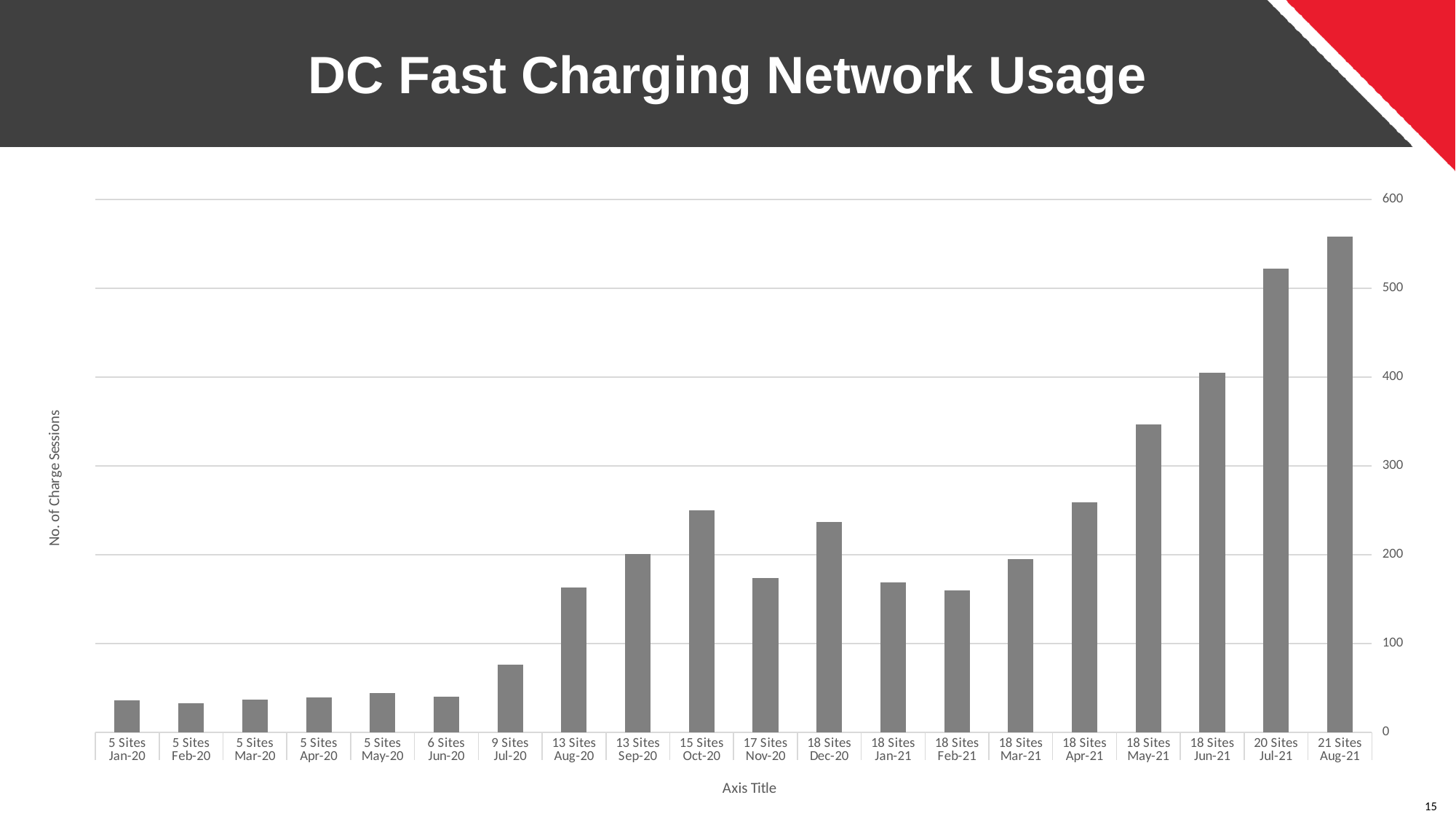
Overall, do the number of charge sessions rise or fall from Jan-20 to Aug-21? rise How many months (bars) are plotted on the chart? 20 Which has more charge sessions, Dec-20 or Jan-21? Dec-20 Is the value for Feb-21 greater or less than 200? less What is the title of the vertical axis? No. of Charge Sessions Is the value for May-21 greater or less than 300? greater Which has more charge sessions, Oct-20 or Nov-20? Oct-20 Which month has the highest number of charge sessions? Aug-21 What kind of chart is shown on the slide? bar chart Is the value for Aug-21 greater or less than 500? greater